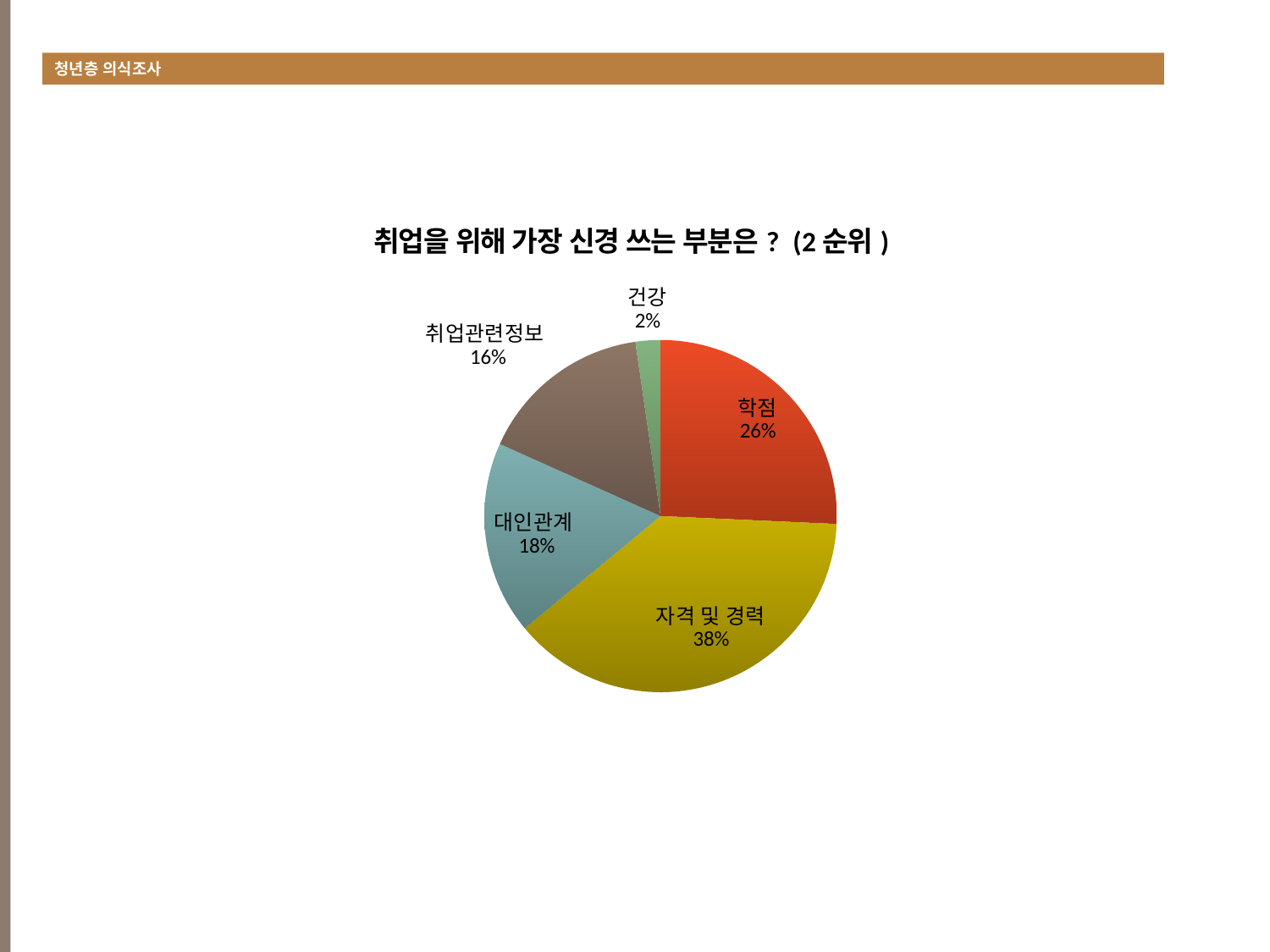
What share of the pie does 자격 및 경력 have? 38% What is the value shown for 대인관계? 18% Which category has the smallest slice? 건강 What is the value shown for 학점? 26% What is the title of the chart? 취업을 위해 가장 신경 쓰는 부분은 ? (2 순위 ) Which category has the largest slice? 자격 및 경력 What colour is the slice for 학점? Red How many categories are shown in the pie chart? 5 Which is larger, 대인관계 or 취업관련정보? 대인관계 What kind of chart is shown on the slide? Pie chart What is the value shown for 취업관련정보? 16% What is the difference between the values for 자격 및 경력 and 학점? 12%